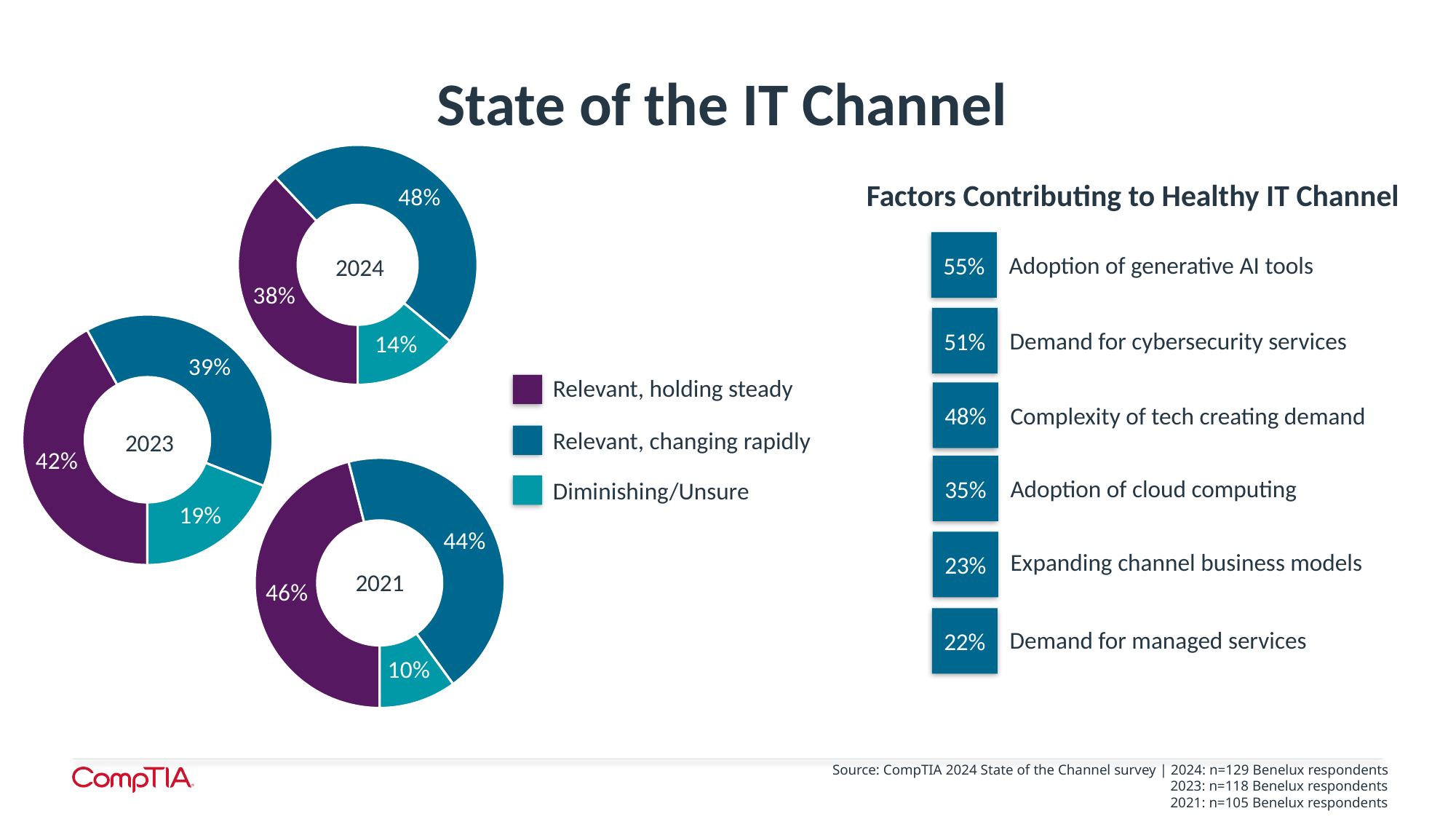
In the 2021 donut chart, which is larger: 'Relevant, holding steady' or 'Relevant, changing rapidly'? Relevant, holding steady In the 2023 donut chart, what share of respondents said the IT channel is 'Relevant, holding steady'? 42% In the 2023 donut chart, which category has the smallest share? Diminishing/Unsure In the 2024 donut chart, what share of respondents said the IT channel is 'Relevant, changing rapidly'? 48% How many donut charts are shown on the slide? 3 In the 'Factors Contributing to Healthy IT Channel' list, what percentage is shown for 'Adoption of cloud computing'? 35% How many categories does the legend for the donut charts list? 3 In the 2021 donut chart, what share of respondents answered 'Diminishing/Unsure'? 10% What is the difference between the 'Diminishing/Unsure' share in 2023 and in 2024? 5% In the 2024 donut chart, which category has the largest share? Relevant, changing rapidly In the 'Factors Contributing to Healthy IT Channel' list, which factor has the highest percentage? Adoption of generative AI tools What type of chart is used to show the 2024, 2023 and 2021 data on the left of the slide? Donut chart